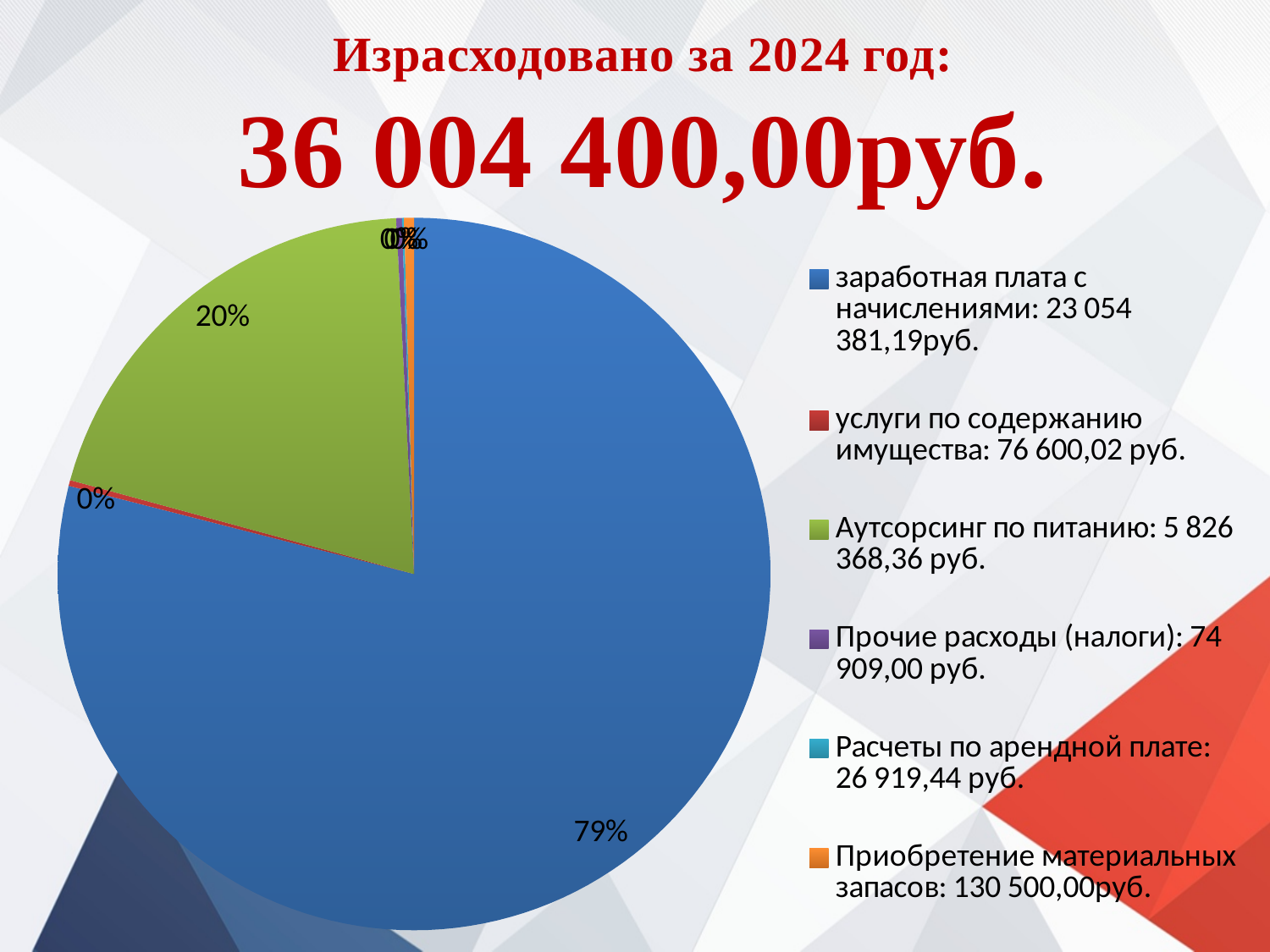
According to the legend, what amount is given for Приобретение материальных запасов? 130 500,00руб. According to the legend, what amount is given for услуги по содержанию имущества? 76 600,02 руб. According to the legend, what amount is given for Прочие расходы (налоги)? 74 909,00 руб. What share of the pie does the slice for заработная плата с начислениями take? 79% What kind of chart is shown on the slide? pie chart What total amount spent in 2024 is stated above the chart? 36 004 400,00руб. Which is larger: the slice for заработная плата с начислениями or the slice for Аутсорсинг по питанию? заработная плата с начислениями How many categories does the legend of the pie chart list? 6 Which category has the largest slice of the pie? заработная плата с начислениями According to the legend, what amount is given for Расчеты по арендной плате? 26 919,44 руб. What colour is the slice for Аутсорсинг по питанию? green What share of the pie does the slice for Аутсорсинг по питанию take? 20%